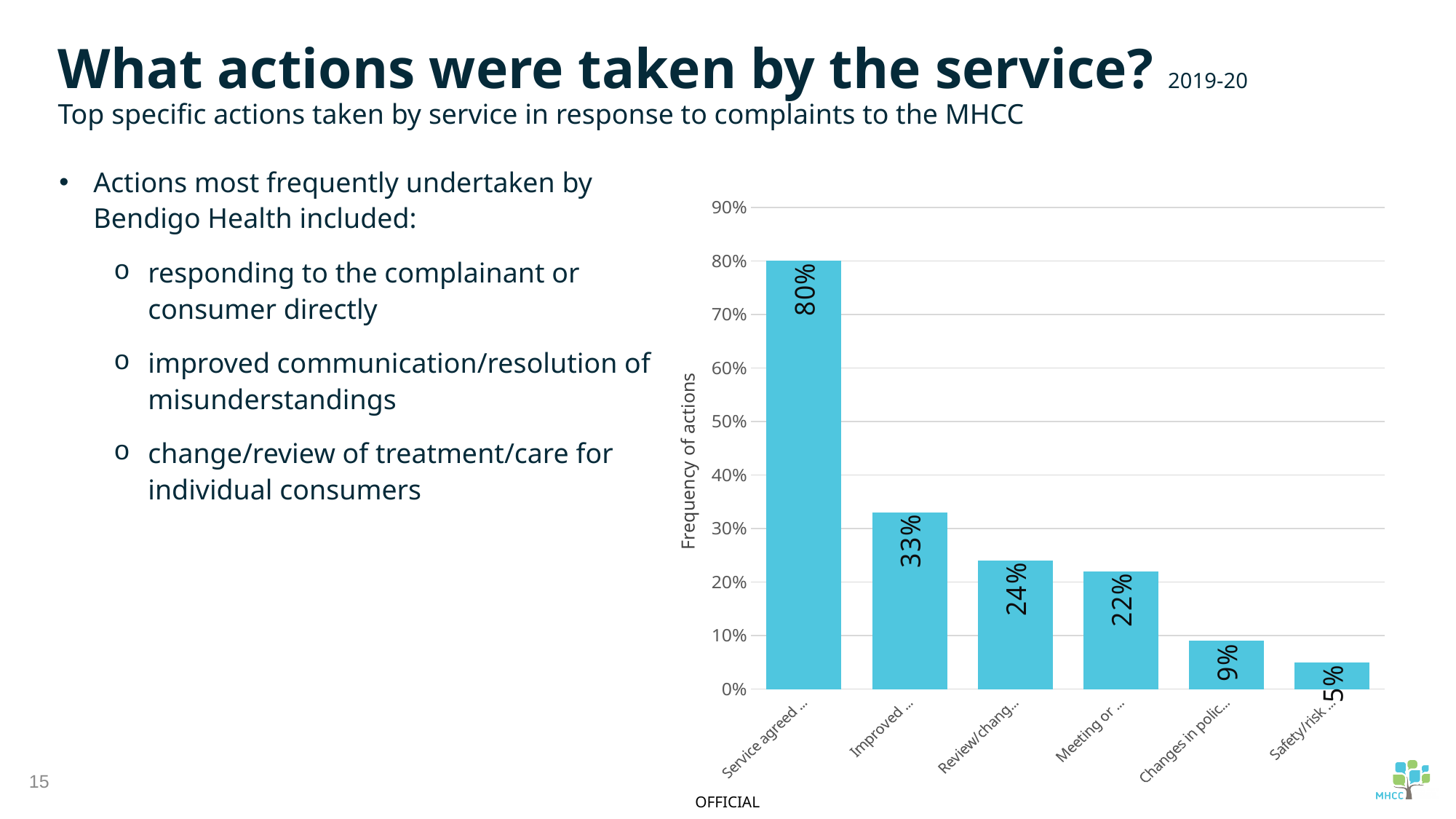
What is the label of the vertical axis? Frequency of actions What is the difference between the first bar (80%) and the second bar (33%)? 47% What is the value of the first bar, labelled 'Service agreed ...'? 80% Which bar has the highest value? Service agreed ... What is the value of the last bar, labelled 'Safety/risk ...'? 5% Which bar has the lowest value? Safety/risk ... What is the value of the second bar, labelled 'Improved ...'? 33% What is the value of the bar labelled 'Changes in polic...'? 9% What is the value of the bar labelled 'Meeting or ...'? 22% How many bars are plotted in the chart? 6 What is the value of the bar labelled 'Review/chang...'? 24% What type of chart is shown on the slide? bar chart